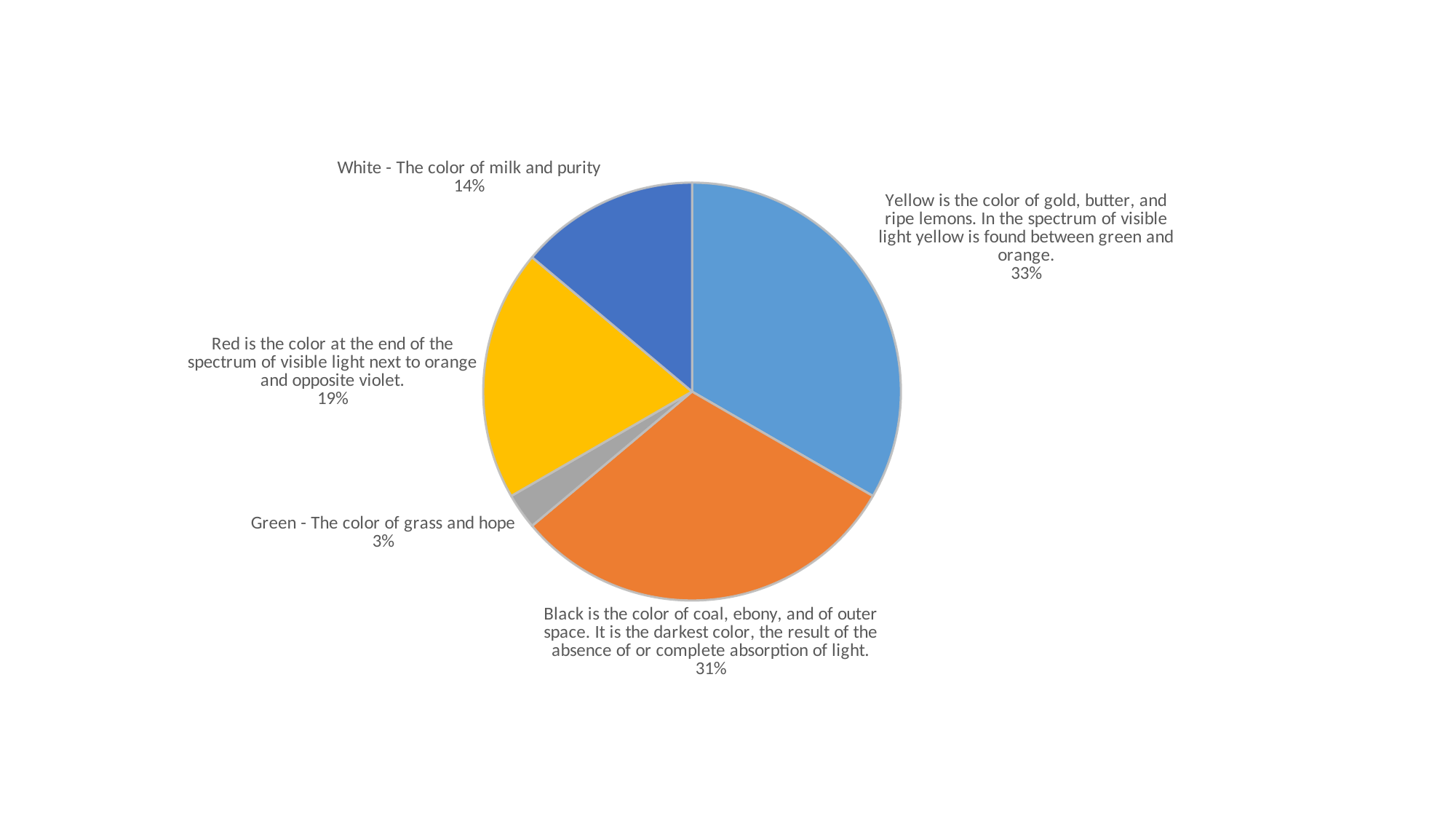
What share of the pie does the Black slice represent? 31% What share of the pie does the Yellow slice represent? 33% What percentage is shown for the White slice? 14% What percentage is shown for the Red slice? 19% What is the difference in percentage points between the Red slice and the White slice? 5 What kind of chart is shown on the slide? pie chart What percentage is shown for the Green slice? 3% Which slice is larger, Red or White? Red Which slice has the smallest share of the pie? Green How many slices does the pie chart have? 5 What colour is the slice labelled 'Green - The color of grass and hope' drawn in? grey Which slice has the largest share of the pie? Yellow